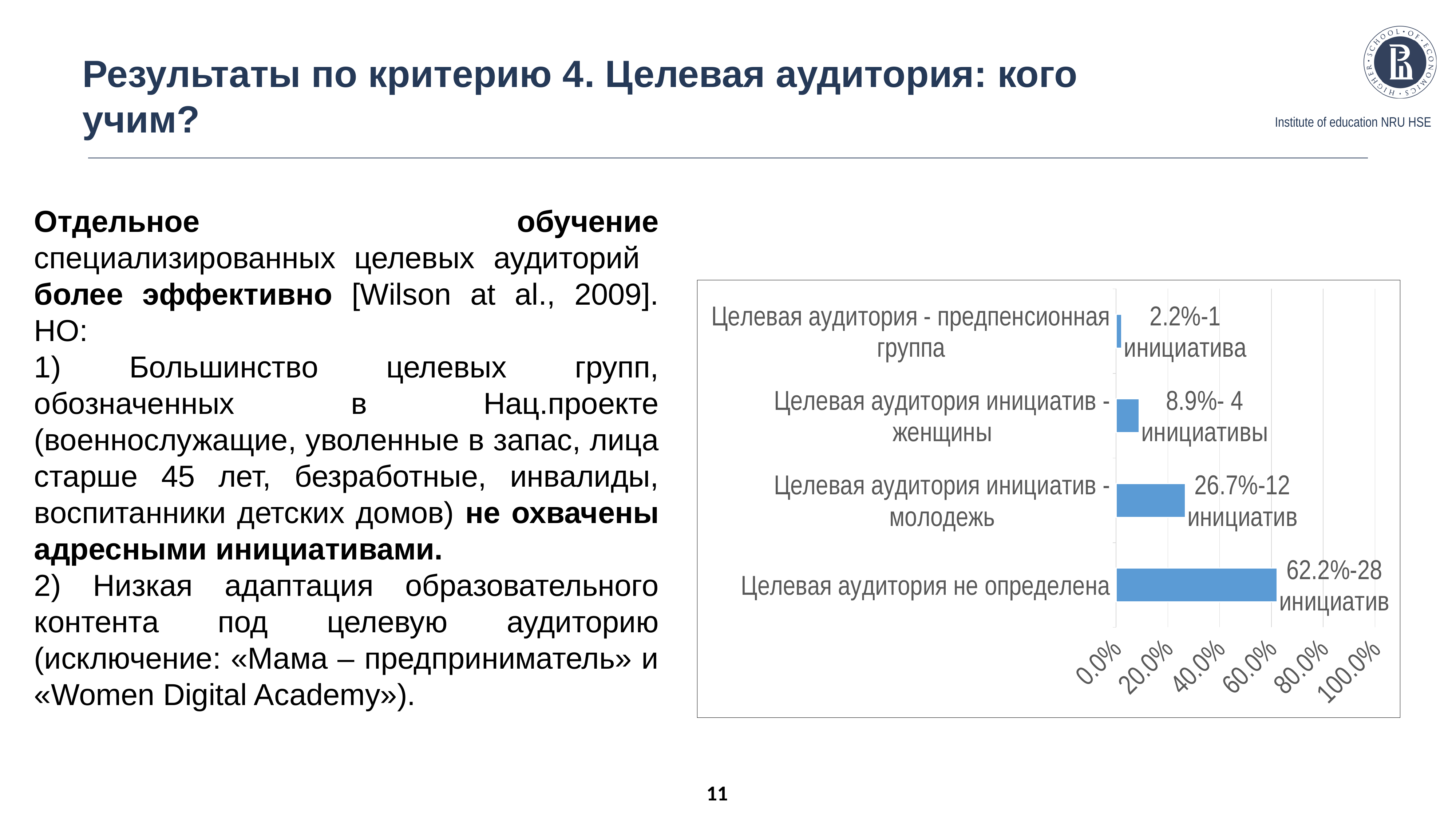
How many initiatives are shown for "Целевая аудитория - предпенсионная группа"? 1 How many categories does the chart show? 4 Is the value for "Целевая аудитория не определена" greater or less than 60.0%? greater What is the difference in percentage points between "Целевая аудитория не определена" and "Целевая аудитория инициатив - молодежь"? 35.5% Which category has the highest value? Целевая аудитория не определена What percentage is shown for "Целевая аудитория не определена"? 62.2% Which is larger: the value for "Целевая аудитория инициатив - женщины" or for "Целевая аудитория инициатив - молодежь"? Целевая аудитория инициатив - молодежь What percentage is shown for "Целевая аудитория инициатив - женщины"? 8.9% Which category has the lowest value? Целевая аудитория - предпенсионная группа What type of chart is shown on the slide? bar chart How many more initiatives does "Целевая аудитория инициатив - молодежь" have than "Целевая аудитория инициатив - женщины"? 8 How many initiatives are shown for "Целевая аудитория инициатив - молодежь"? 12